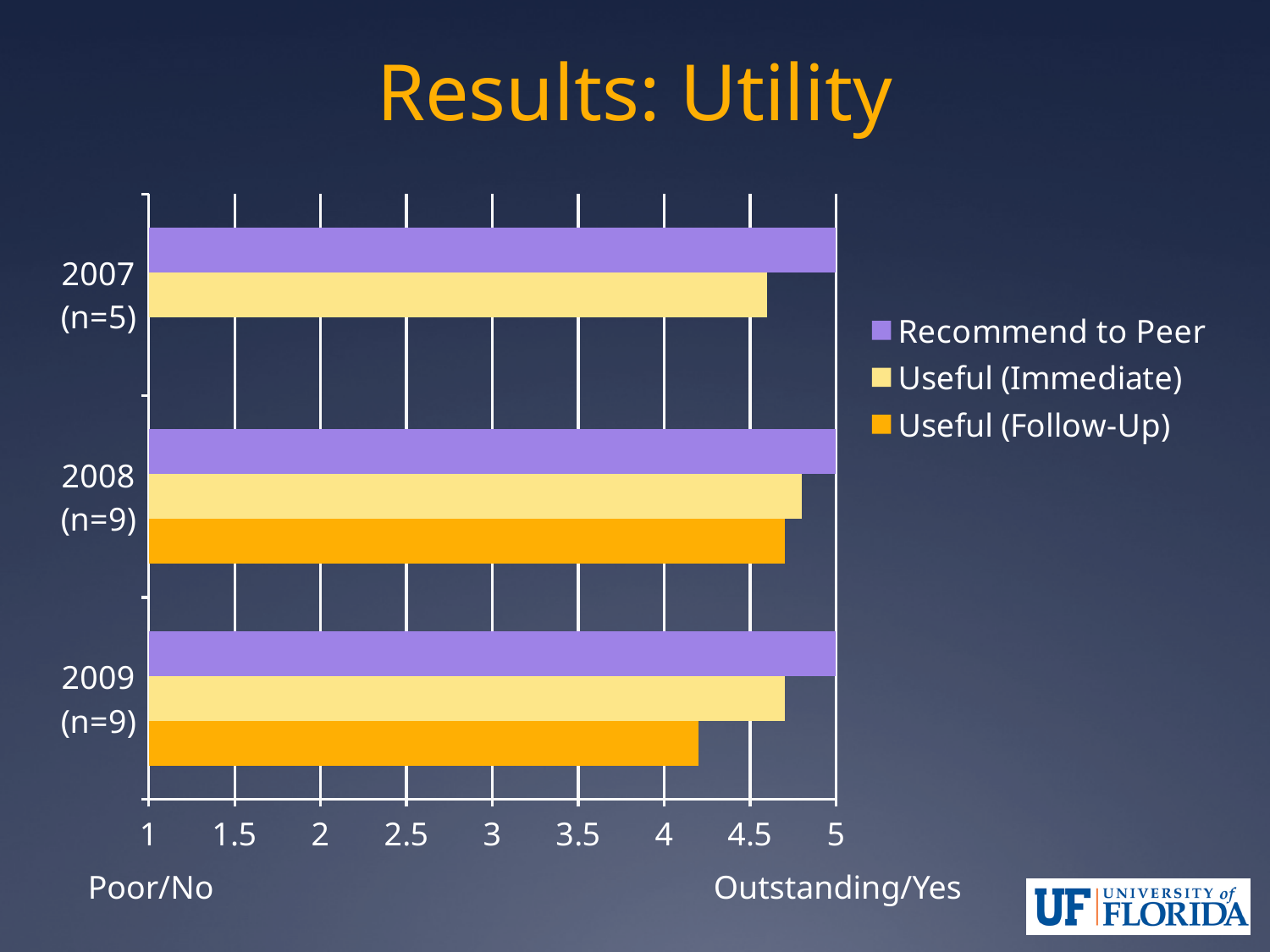
What is the title of the slide? Results: Utility What is the value for Recommend to Peer in 2007 (n=5)? 5 Is the value for Useful (Immediate) in 2008 (n=9) greater or less than 4.5? greater What kind of chart is shown on the slide? bar chart Which series has the highest value in 2009 (n=9)? Recommend to Peer What is the value for Recommend to Peer in 2009 (n=9)? 5 In 2009 (n=9), which is larger: Useful (Immediate) or Useful (Follow-Up)? Useful (Immediate) How many year categories are shown on the chart? 3 Is the value for Useful (Follow-Up) in 2009 (n=9) greater or less than 4? greater Which year has the lowest value for Useful (Follow-Up)? 2009 (n=9) Is the value for Useful (Follow-Up) in 2009 (n=9) greater or less than 4.5? less How many series does the legend list? 3